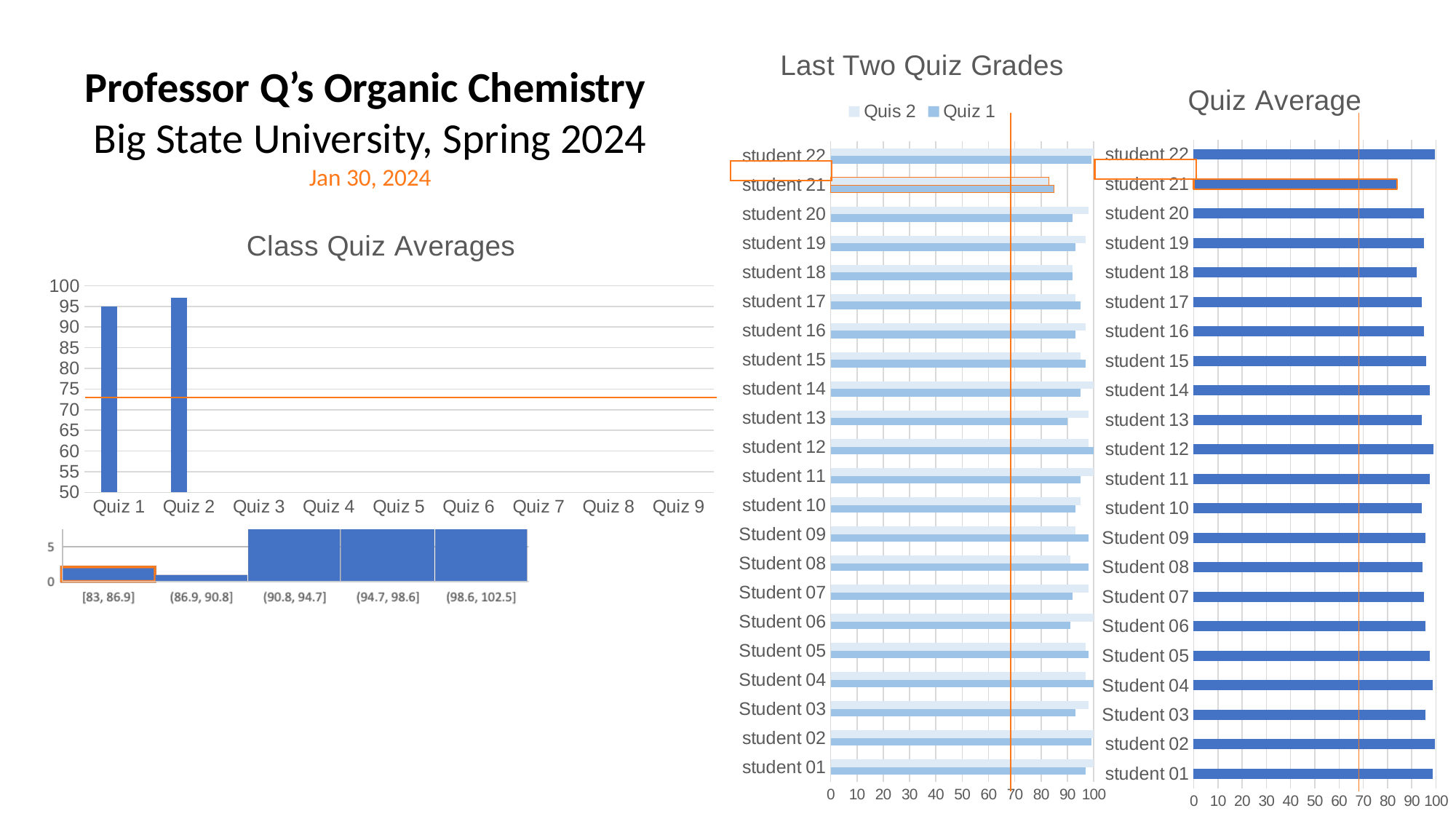
How many students are listed in the "Last Two Quiz Grades" chart? 22 In the "Class Quiz Averages" chart, is the value for Quiz 2 greater or less than 95? greater How many series does the legend of the "Last Two Quiz Grades" chart list? 2 How many bins are shown on the x axis of the histogram below the "Class Quiz Averages" chart? 5 In the "Class Quiz Averages" chart, which is higher, Quiz 1 or Quiz 2? Quiz 2 What kind of chart is the "Class Quiz Averages" chart? bar chart In the "Last Two Quiz Grades" chart, which student has the lowest Quiz 1 grade? student 21 How many quiz categories are shown on the x axis of the "Class Quiz Averages" chart? 9 What are the two legend entries in the "Last Two Quiz Grades" chart? Quis 2 and Quiz 1 In the "Quiz Average" chart, is the value for student 21 greater or less than 90? less In the "Class Quiz Averages" chart, is the value for Quiz 1 greater or less than 90? greater In the "Quiz Average" chart, which student has the lowest quiz average? student 21